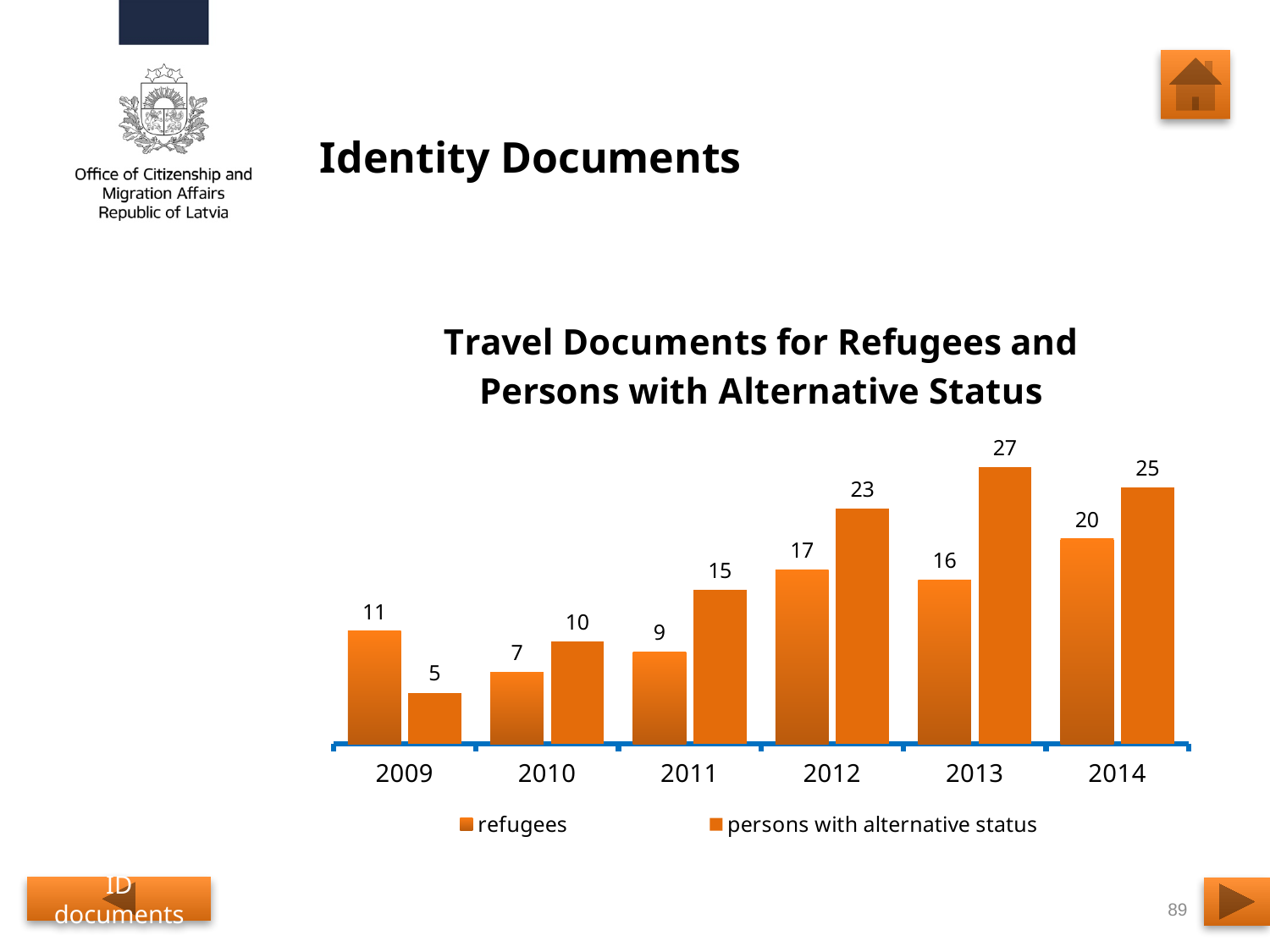
In which year is the value for refugees lowest? 2010 What is the value for refugees in 2012? 17 Do the values for persons with alternative status generally rise or fall from 2009 to 2013? rise What is the title of the chart? Travel Documents for Refugees and Persons with Alternative Status What is the value for persons with alternative status in 2013? 27 How many years are shown on the x axis? 6 What is the value for refugees in 2009? 11 How many series does the legend list? 2 In which year is the value for persons with alternative status highest? 2013 What is the difference between persons with alternative status and refugees in 2014? 5 Which is larger in 2009: refugees or persons with alternative status? refugees What kind of chart is shown on the slide? bar chart